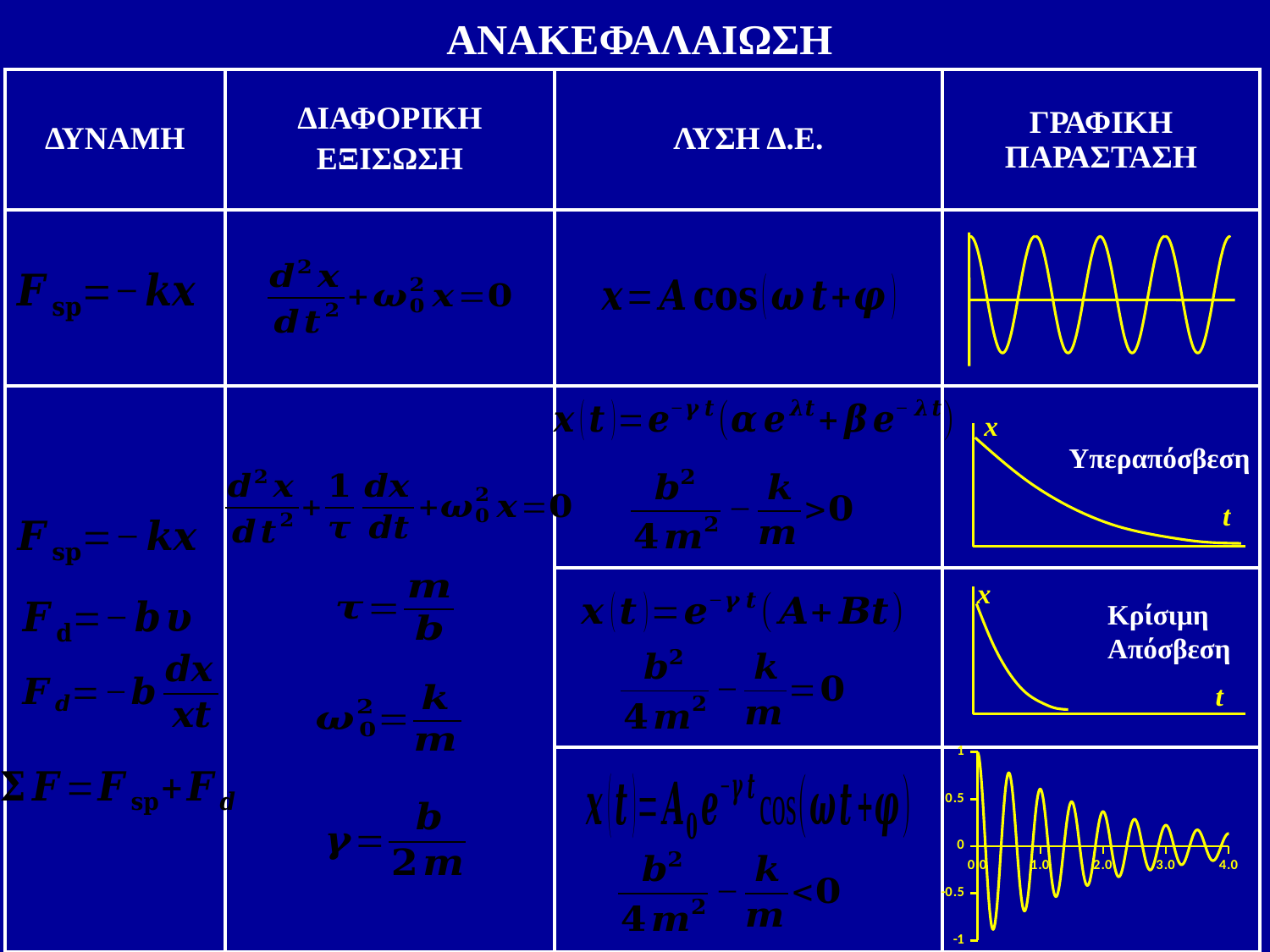
In the bottom-right graph, does the amplitude of the oscillation increase or decrease as the horizontal axis value increases? decrease What is the text label shown next to the second graph in the right column? Υπεραπόσβεση What is the lowest tick value on the vertical axis of the bottom-right graph? -1 What is the largest tick value on the horizontal axis of the bottom-right graph? 4.0 In the graph labelled Υπεραπόσβεση, does x rise or fall as t increases? fall What kind of chart is the graph in the bottom-right cell of the table? line chart What colour are the curves drawn in the graphs on the slide? yellow In the graph labelled Κρίσιμη Απόσβεση, does x rise or fall as t increases? fall What is the highest tick value on the vertical axis of the bottom-right graph? 1 How many graphs are shown in the ΓΡΑΦΙΚΗ ΠΑΡΑΣΤΑΣΗ column of the table? 4